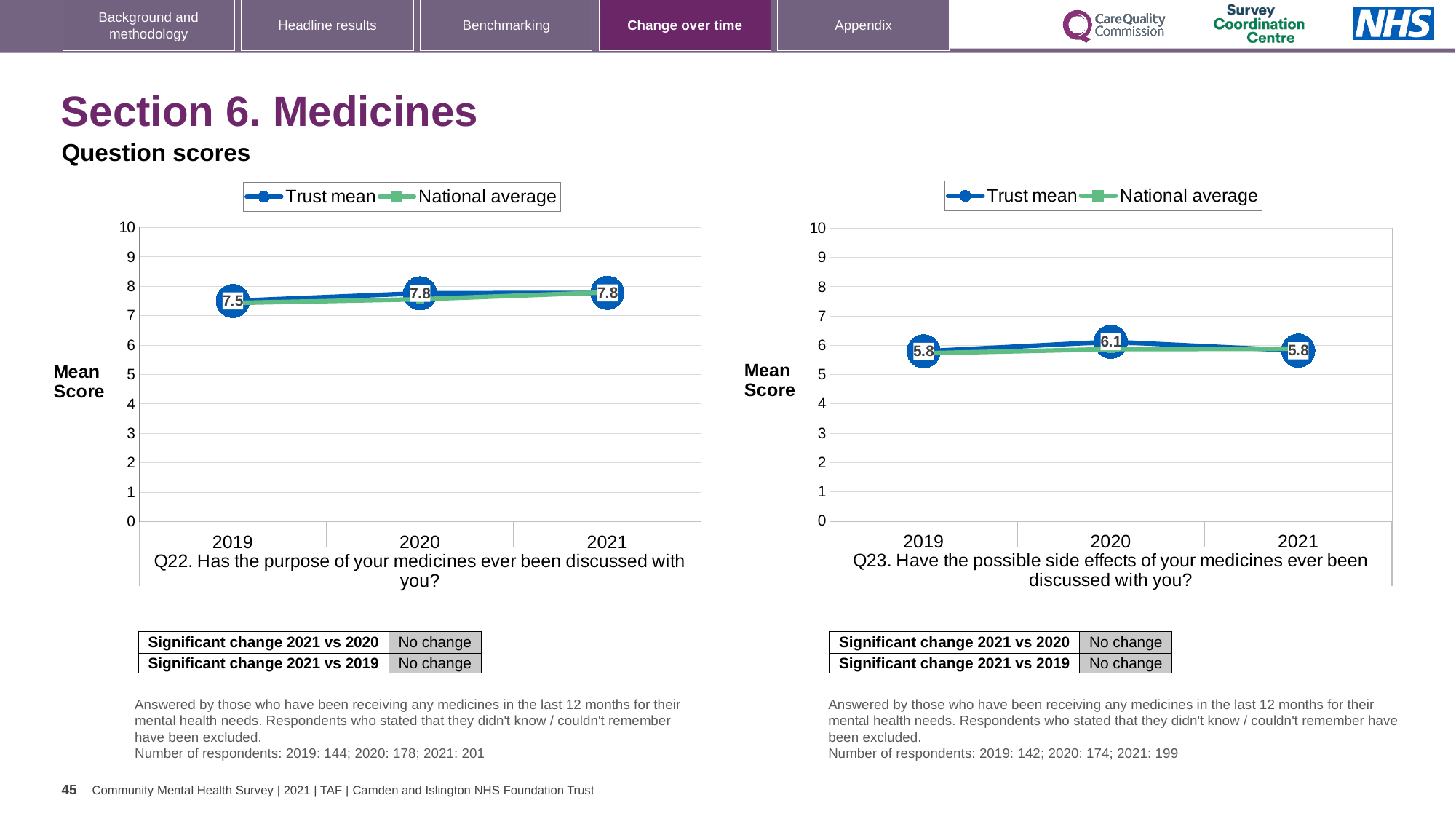
In the left chart (Q22), which year has the lowest Trust mean? 2019 How many series does the legend of the right chart (Q23) list? 2 In the left chart (Q22), what is the Trust mean for 2019? 7.5 In the left chart (Q22), what is the difference between the Trust mean in 2020 and in 2019? 0.3 How many years are plotted on the x axis of the left chart (Q22)? 3 In the right chart (Q23), what is the Trust mean for 2020? 6.1 In the right chart (Q23), does the Trust mean rise or fall from 2020 to 2021? Fall In the left chart (Q22), what is the Trust mean for 2021? 7.8 In the right chart (Q23), which year has the highest Trust mean? 2020 In the right chart (Q23), is the Trust mean for 2020 greater or less than 6? greater In the right chart (Q23), what is the Trust mean for 2021? 5.8 What type of chart is used for Q22 on the left? Line chart